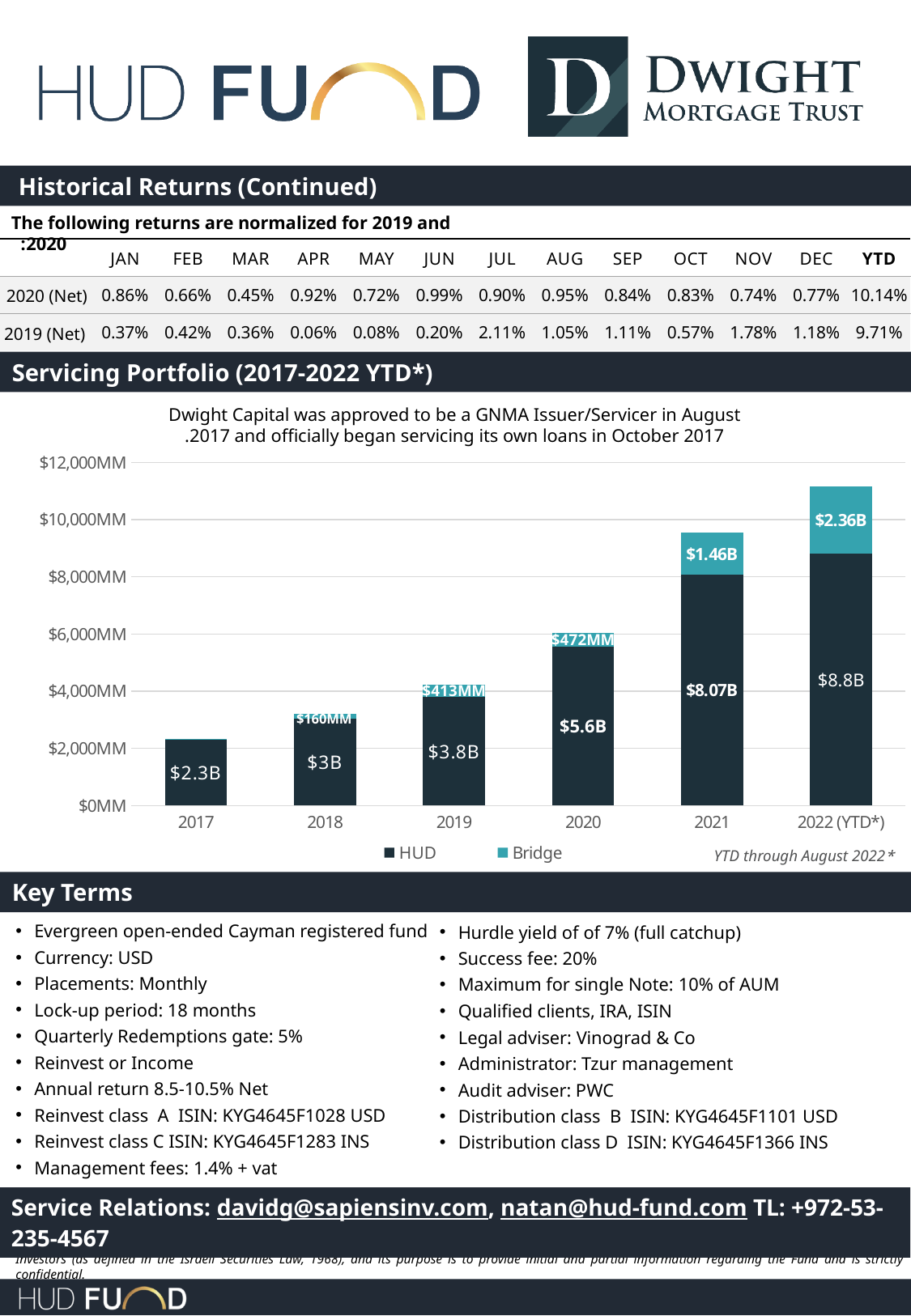
How many years are shown on the x axis of the Servicing Portfolio chart? 6 What is the HUD value for 2020 in the Servicing Portfolio chart? $5.6B What is the difference between the HUD values for 2022 (YTD*) and 2021 in the Servicing Portfolio chart? $0.73B Which year has the highest HUD value in the Servicing Portfolio chart? 2022 (YTD*) What is the Bridge value for 2022 (YTD*) in the Servicing Portfolio chart? $2.36B Which is larger in the Servicing Portfolio chart: the Bridge value for 2021 or the Bridge value for 2020? 2021 Which year has the lowest HUD value in the Servicing Portfolio chart? 2017 What is the Bridge value for 2019 in the Servicing Portfolio chart? $413MM How many series does the legend of the Servicing Portfolio chart list? 2 What is the total of the stacked bar for 2021 in the Servicing Portfolio chart? $9.53B Is the total bar for 2017 in the Servicing Portfolio chart greater or less than $4,000MM? less What type of chart is shown in the Servicing Portfolio section? Stacked bar chart